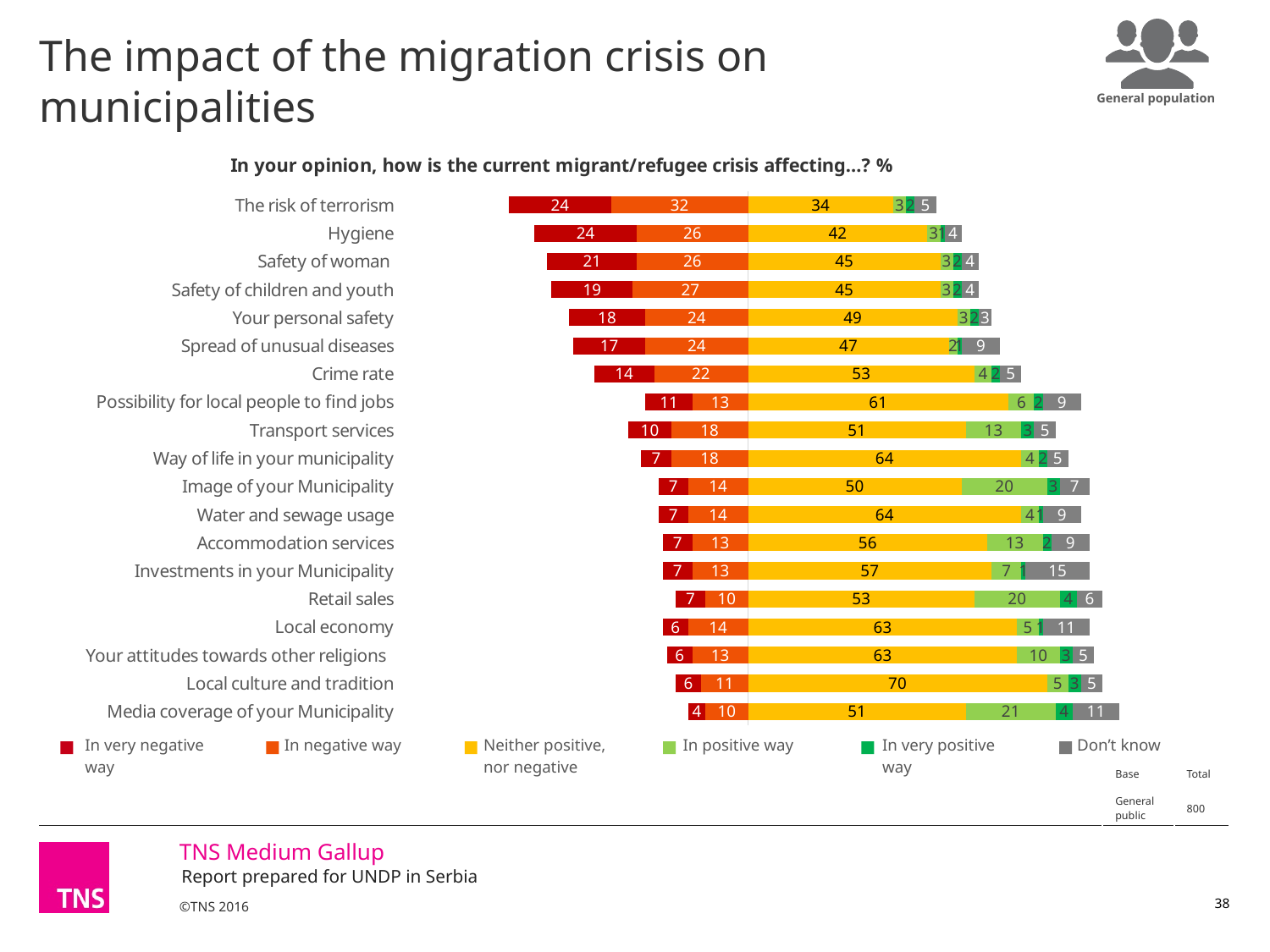
How many categories (items) are shown in the chart? 19 Which has a larger 'In very negative way' value: Crime rate or Transport services? Crime rate Which category has the lowest 'In very negative way' value? Media coverage of your Municipality Which legend entry is shown in grey? Don't know What is the 'Don't know' value for Investments in your Municipality? 15 Which category has the highest 'Neither positive, nor negative' value? Local culture and tradition What type of chart is shown on the slide? Stacked bar chart What percentage of respondents said the migrant/refugee crisis affects the risk of terrorism in a very negative way? 24 How many series does the legend list? 6 What is the 'In positive way' value for Media coverage of your Municipality? 21 What is the difference between the 'In negative way' values for The risk of terrorism and Hygiene? 6 What is the 'Neither positive, nor negative' value for Local culture and tradition? 70